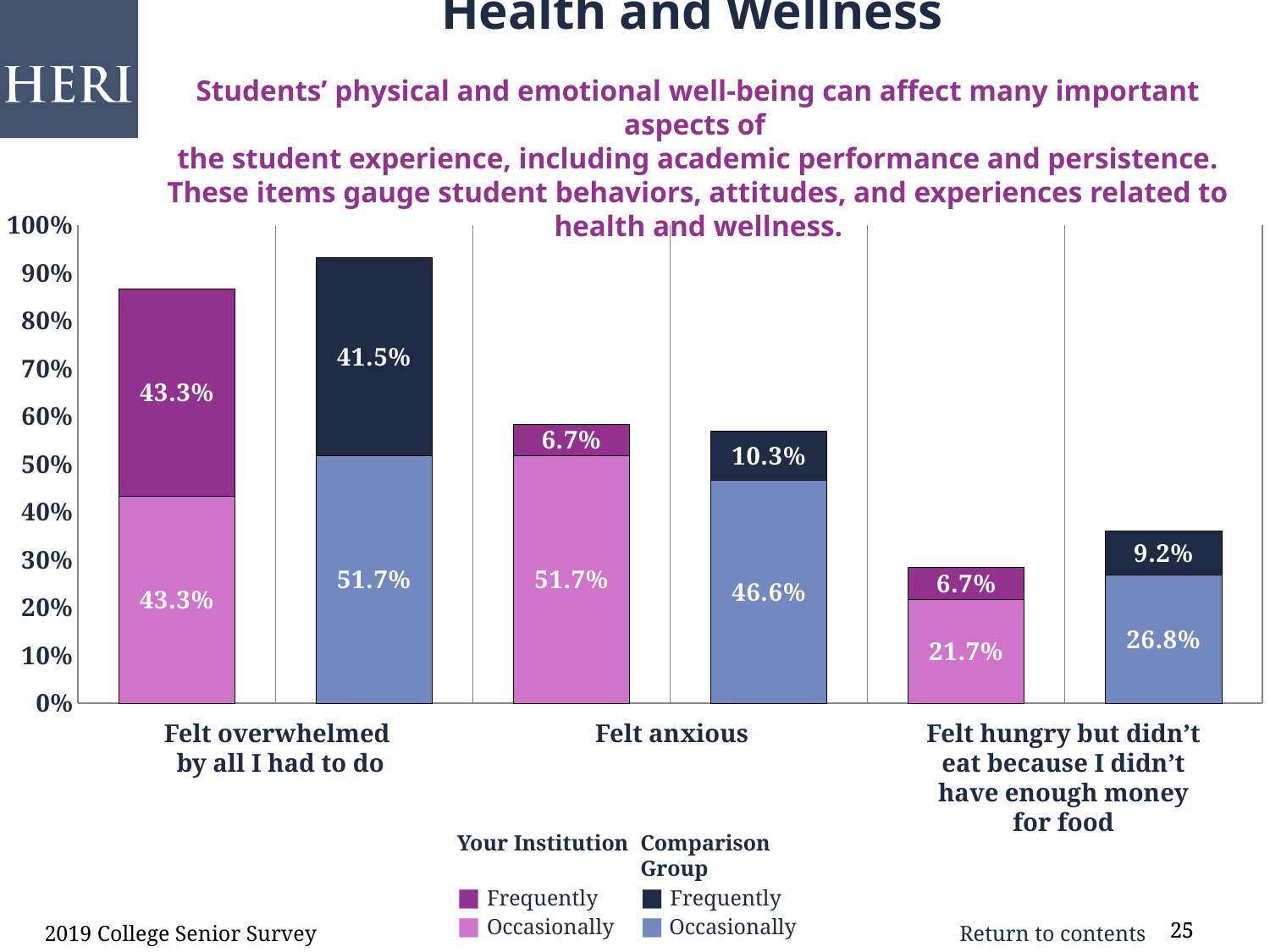
Which is larger for 'Felt hungry but didn't eat because I didn't have enough money for food': the Occasionally value for Your Institution or for the Comparison Group? Comparison Group What kind of chart is shown on the slide? Stacked bar chart Which item has the highest 'Occasionally' value for Your Institution? Felt anxious What percentage of the Comparison Group reported occasionally feeling anxious? 46.6% What is the difference between the Comparison Group's 'Frequently' value and Your Institution's 'Frequently' value for 'Felt anxious'? 3.6% How many items (categories) are shown on the x axis of the chart? 3 Which item has the lowest 'Frequently' value for the Comparison Group? Felt hungry but didn't eat because I didn't have enough money for food What is the total percentage (Frequently plus Occasionally) for the Your Institution bar for 'Felt anxious'? 58.4% What is the total percentage (Frequently plus Occasionally) for the Comparison Group bar for 'Felt overwhelmed by all I had to do'? 93.2% What percentage of students at Your Institution reported frequently feeling overwhelmed by all they had to do? 43.3% How many series does the legend list? 4 What percentage of students at Your Institution reported occasionally feeling hungry but not eating because they didn't have enough money for food? 21.7%